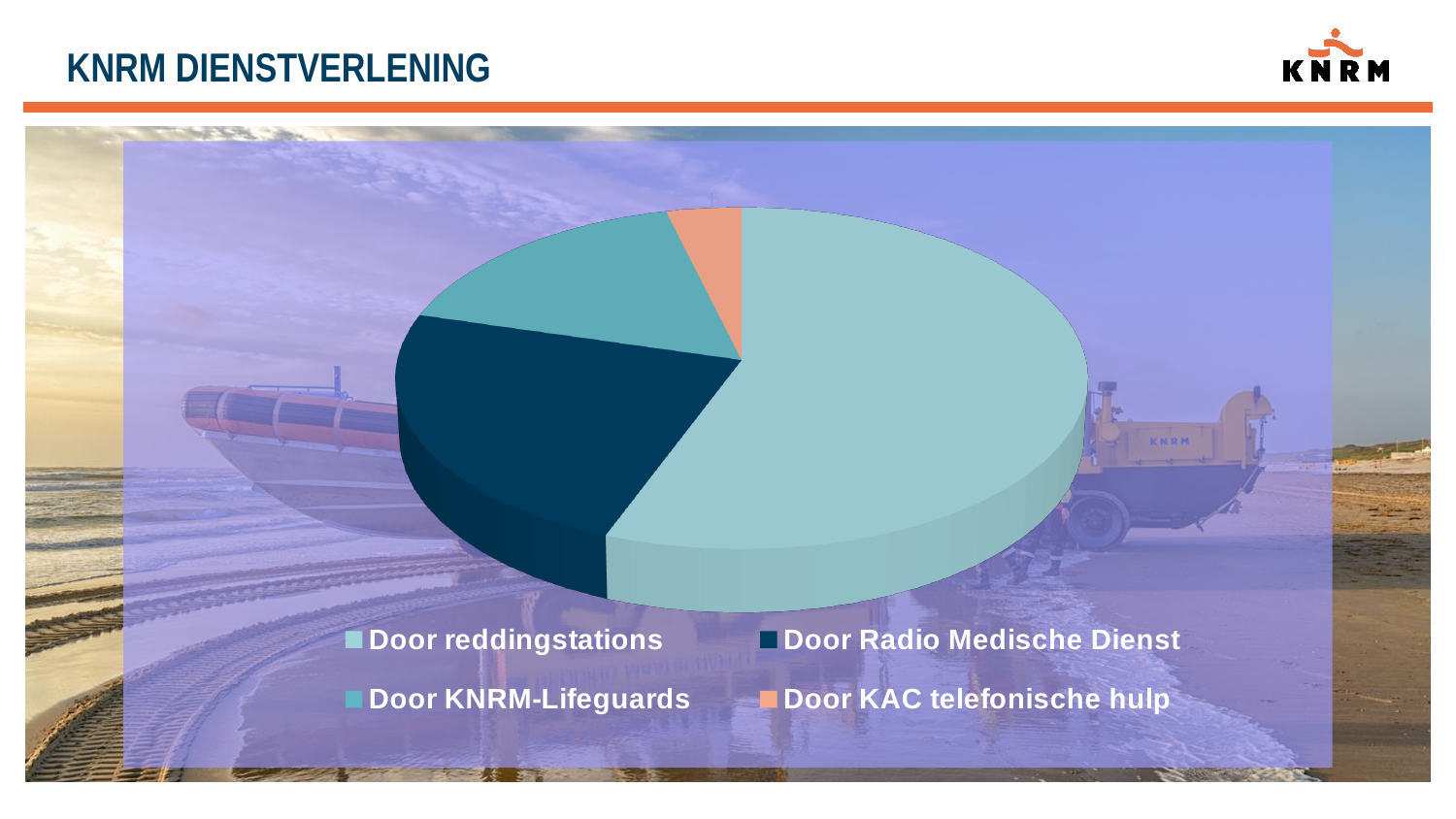
How many slices does the pie chart have? 4 Which category has the largest slice of the pie? Door reddingstations How many entries does the legend list? 4 Which legend entry is shown in orange? Door KAC telefonische hulp Which slice is larger: Door Radio Medische Dienst or Door KNRM-Lifeguards? Door Radio Medische Dienst What kind of chart is shown on the slide? Pie chart What is the title of the slide containing the pie chart? KNRM DIENSTVERLENING Which category has the smallest slice of the pie? Door KAC telefonische hulp Which category has the second-largest slice of the pie? Door Radio Medische Dienst Which slice is larger: Door reddingstations or Door Radio Medische Dienst? Door reddingstations Which slice is larger: Door KNRM-Lifeguards or Door KAC telefonische hulp? Door KNRM-Lifeguards